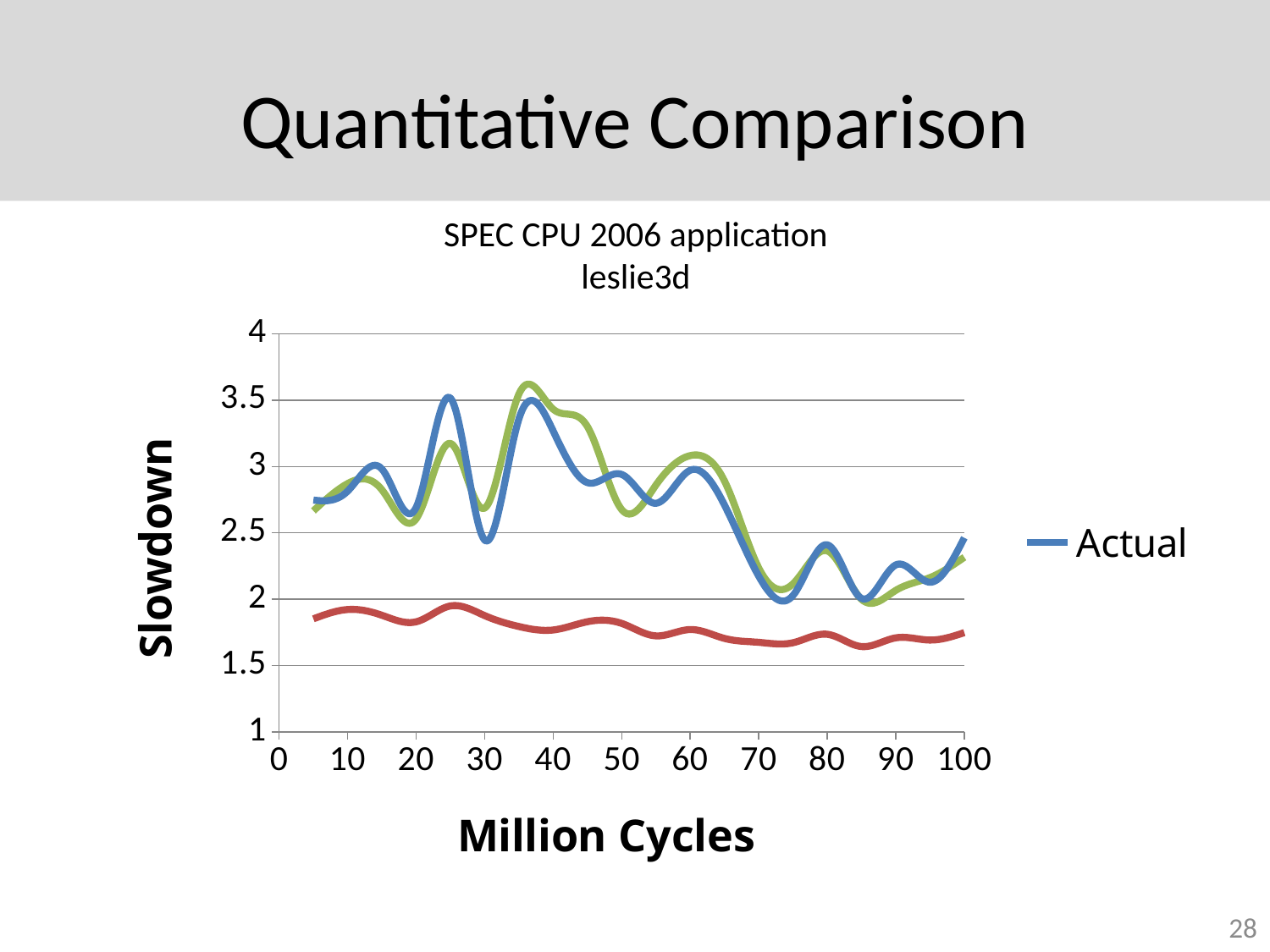
What is the label on the y axis of the chart? Slowdown What is the title of the chart? SPEC CPU 2006 application leslie3d Is the Actual value at 25 million cycles greater or less than 3? greater Is the Actual value at 75 million cycles greater or less than 2.5? less Between 60 and 75 million cycles, does the Actual line rise or fall? fall At 25 million cycles, is the Actual line higher or lower than the green line? higher What kind of chart is shown on the slide? line chart Which line stays lowest across the whole x axis? the red line Is the Actual value at 10 million cycles greater or less than 2.5? greater At 30 million cycles, is the Actual line higher or lower than the green line? lower How many series does the chart's legend list? 1